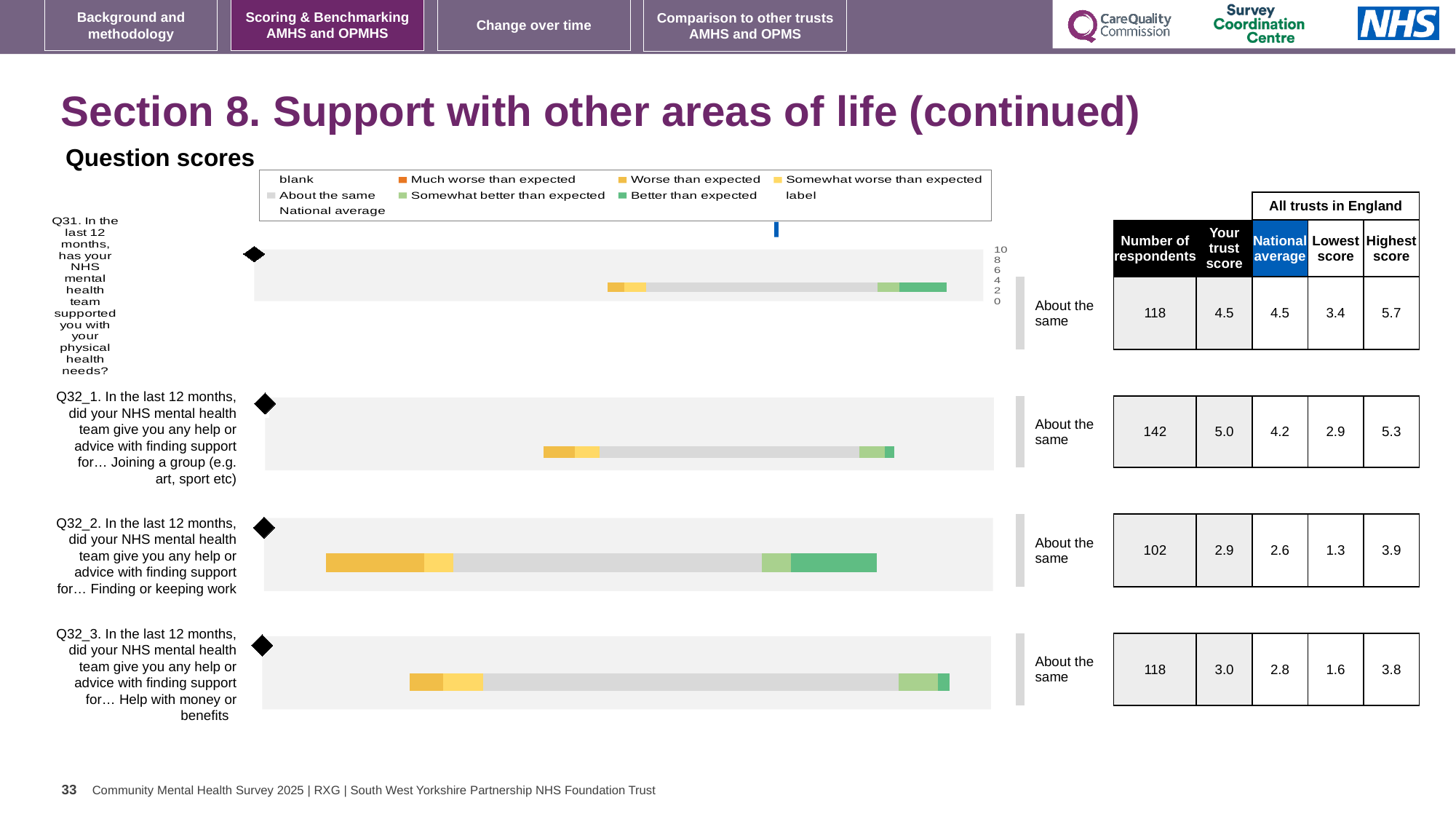
Is the trust score for Q32_1 larger or smaller than its national average? larger What is the 'Your trust score' for Q32_1 (Joining a group)? 5.0 How many respondents answered Q32_3 (Help with money or benefits)? 118 Which question has the highest 'Your trust score'? Q32_1 (Joining a group) What is the national average for Q32_2 (Finding or keeping work)? 2.6 How many entries does the legend above the charts list? 9 What is the difference between the highest score and the lowest score for Q31? 2.3 Which legend entry is shown in grey? About the same Which legend entry is shown in orange? Much worse than expected What kind of chart is used to show the question scores on this slide? bar chart How many question bars are plotted on the slide? 4 Which question has the lowest 'Your trust score'? Q32_2 (Finding or keeping work)